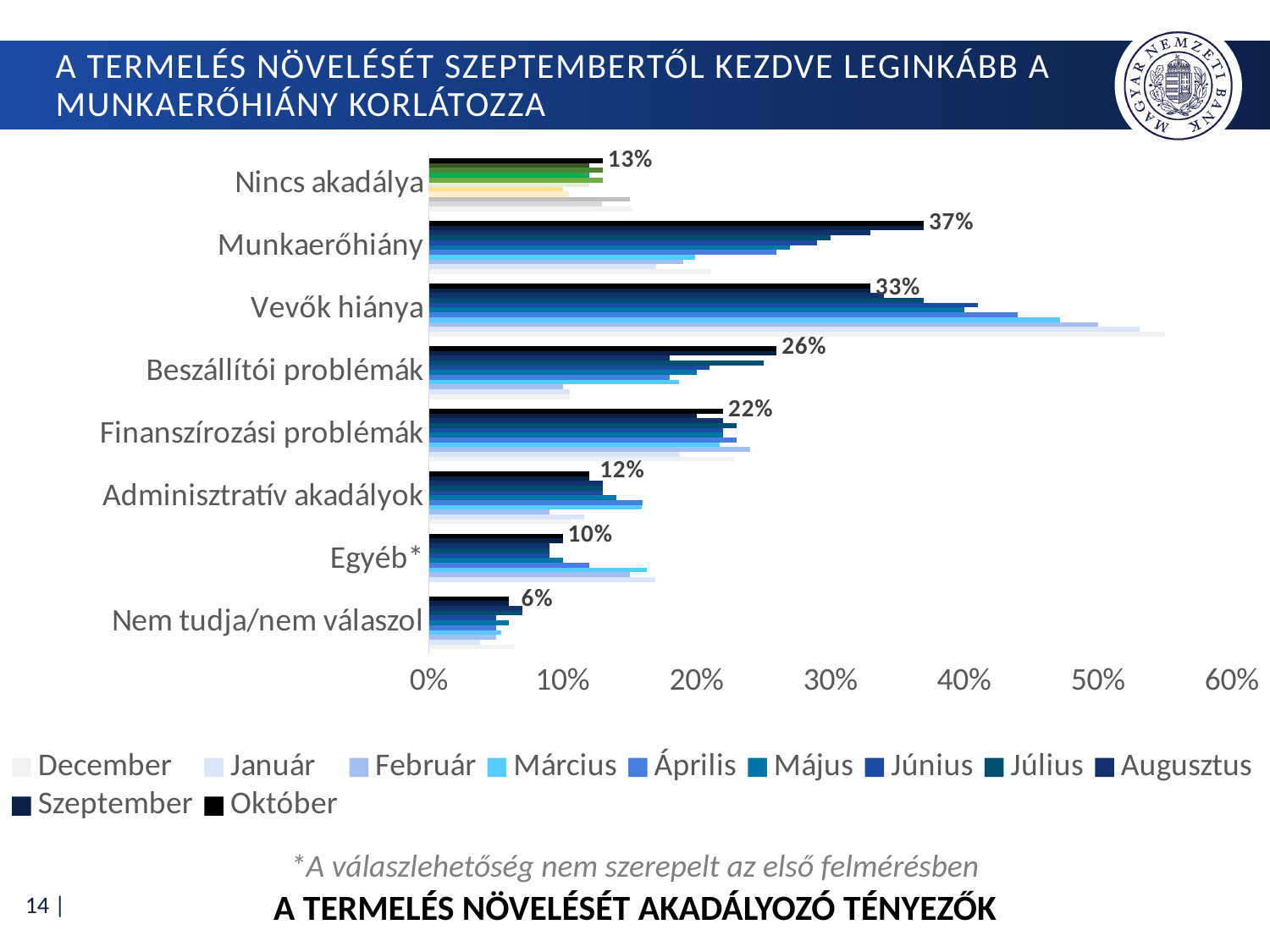
Is the December value for Vevők hiánya greater or less than 50%? greater Which category has the lowest Október value? Nem tudja/nem válaszol What is the Október value for Vevők hiánya? 33% What is the difference between the Október values for Munkaerőhiány and Vevők hiánya? 4 percentage points How many series does the legend list? 11 What kind of chart is shown on the slide? bar chart How many categories are shown on the chart? 8 Which category has the highest Október value? Munkaerőhiány What is the Október value for Beszállítói problémák? 26% Which has the larger Október value, Finanszírozási problémák or Adminisztratív akadályok? Finanszírozási problémák What is the Október value for Munkaerőhiány? 37% What is the Október value for Nem tudja/nem válaszol? 6%